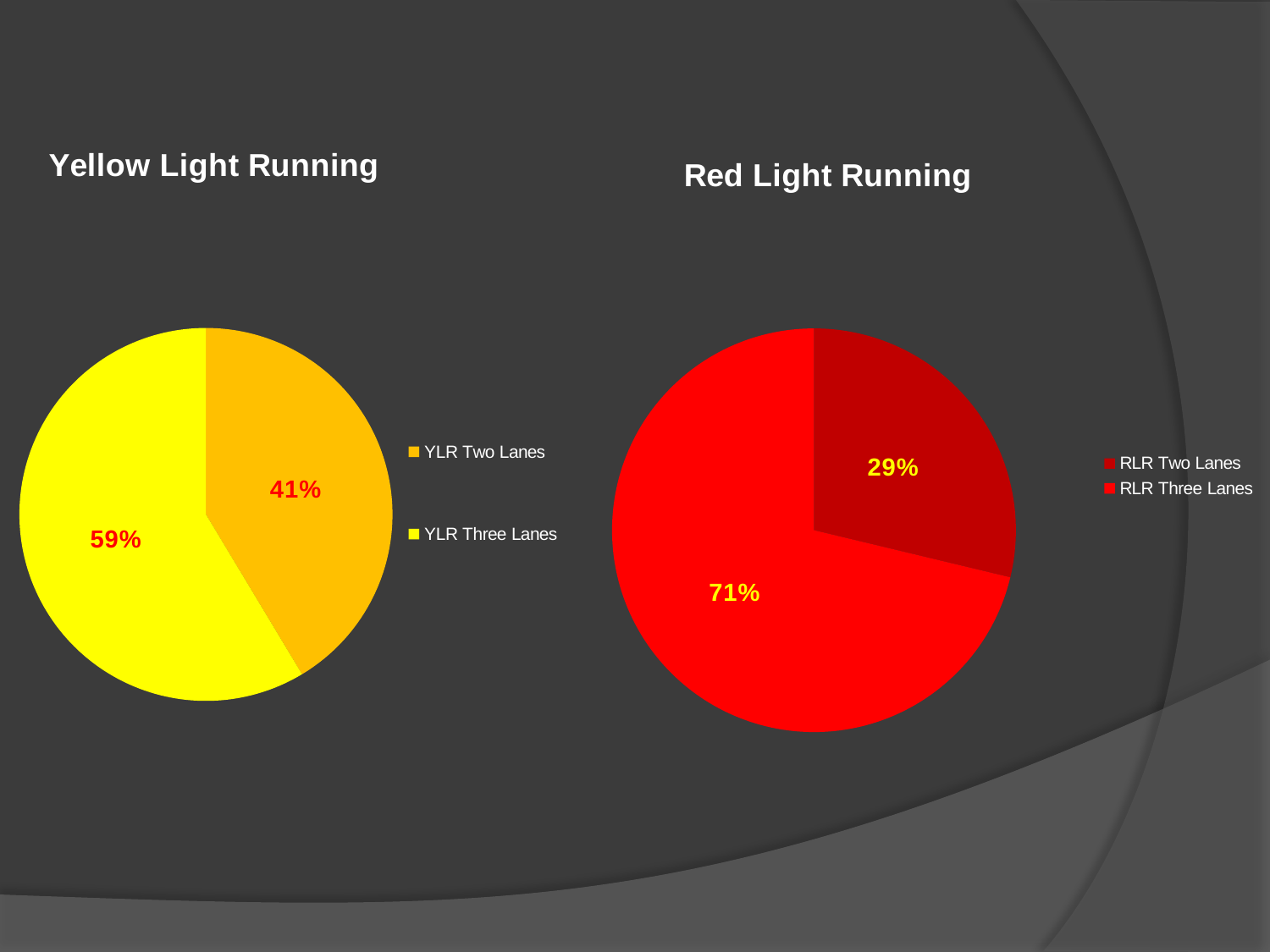
In the Yellow Light Running chart, which slice is the largest? YLR Three Lanes In the Yellow Light Running chart, what share is labelled for YLR Three Lanes? 59% In the Red Light Running chart, which slice is the smallest? RLR Two Lanes In the Red Light Running chart, what colour is the RLR Two Lanes slice? Dark red In the Red Light Running chart, what share is labelled for RLR Two Lanes? 29% What kind of chart is the Red Light Running chart? Pie chart Which is larger: the RLR Three Lanes share in the Red Light Running chart or the YLR Three Lanes share in the Yellow Light Running chart? RLR Three Lanes In the Red Light Running chart, what share is labelled for RLR Three Lanes? 71% In the Red Light Running chart, what is the difference in percentage points between RLR Three Lanes and RLR Two Lanes? 42 In the Yellow Light Running chart, what is the difference in percentage points between YLR Three Lanes and YLR Two Lanes? 18 In the Yellow Light Running chart, what share is labelled for YLR Two Lanes? 41% How many slices does the Yellow Light Running pie chart have? 2